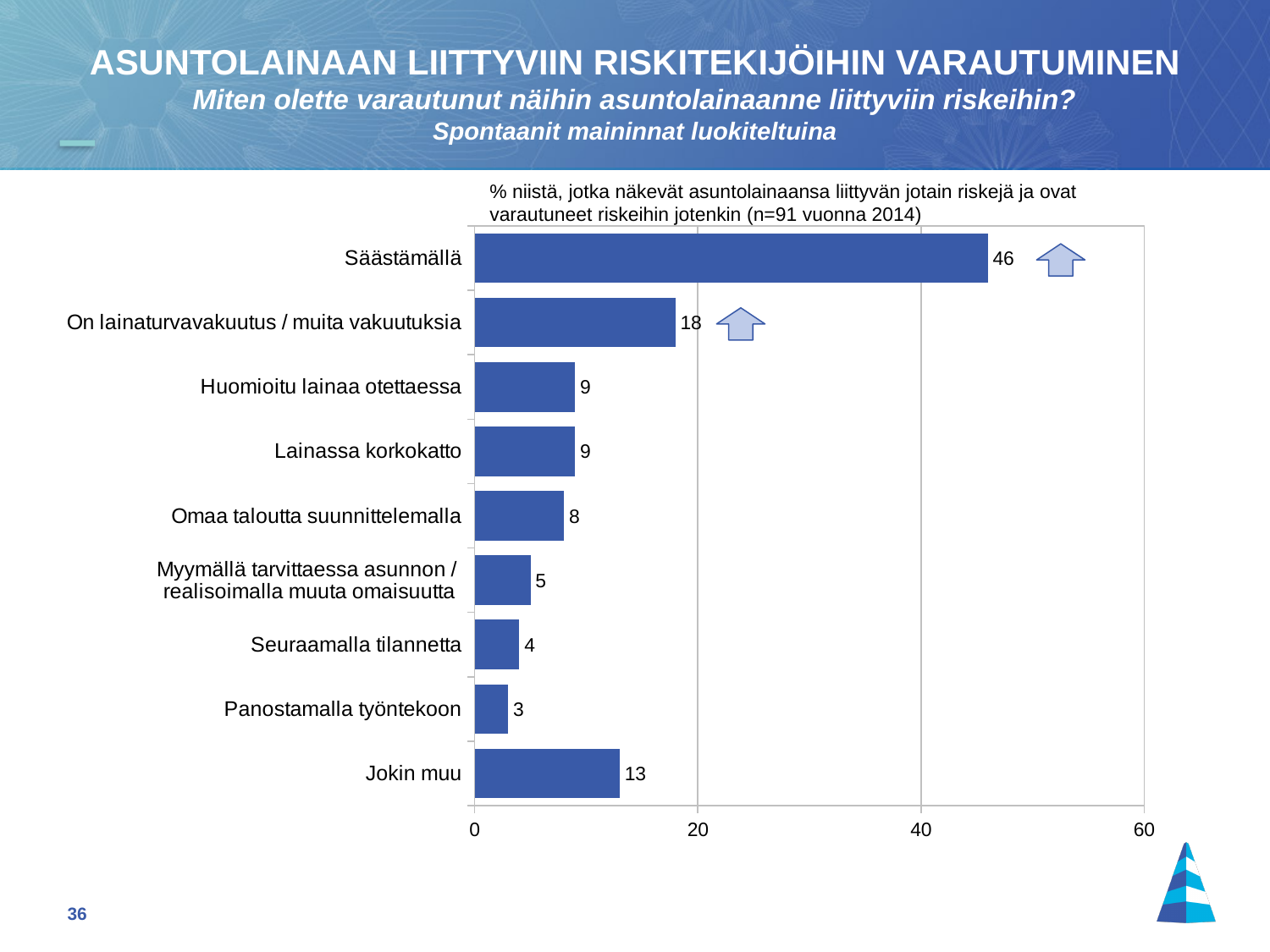
Is the value for Säästämällä greater or less than 40? greater Which category has the lowest value? Panostamalla työntekoon What kind of chart is shown on the slide? Bar chart What is the difference between the values for Säästämällä and On lainaturvavakuutus / muita vakuutuksia? 28 How many categories are shown in the chart? 9 What is the value for On lainaturvavakuutus / muita vakuutuksia? 18 Which is larger, the value for Jokin muu or the value for Omaa taloutta suunnittelemalla? Jokin muu Which category has the highest value? Säästämällä What is the value for Panostamalla työntekoon? 3 What is the value for Säästämällä? 46 What is the value for Jokin muu? 13 What is the highest value shown on the x axis? 60